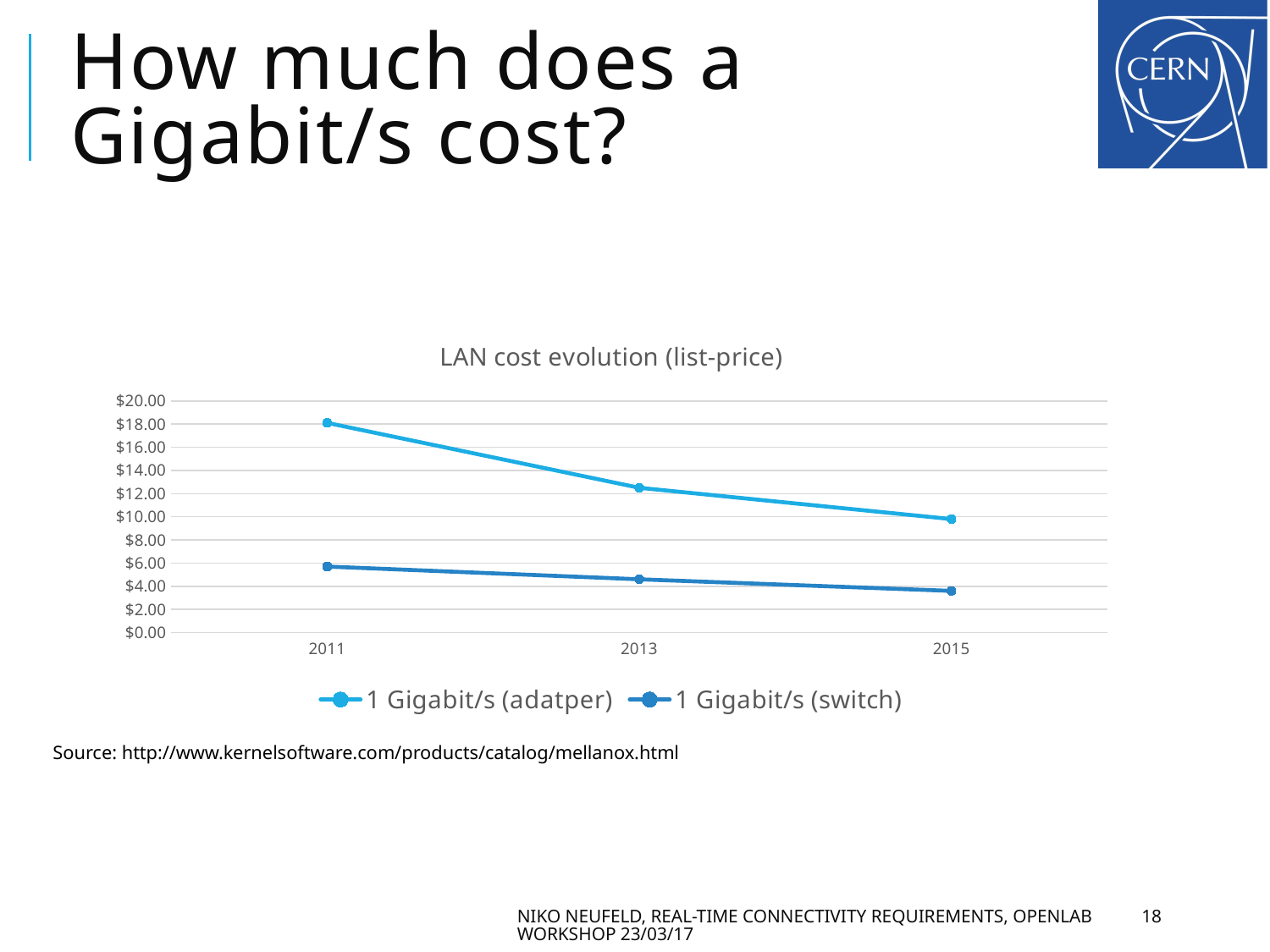
Does the cost for 1 Gigabit/s (switch) rise or fall from 2011 to 2015? fall In which year is the value for 1 Gigabit/s (adatper) highest? 2011 Is the value for 1 Gigabit/s (adatper) in 2015 greater or less than $12.00? less What kind of chart is shown on the slide? line chart How many years are plotted along the x axis? 3 Is the value for 1 Gigabit/s (adatper) in 2011 greater or less than $16.00? greater Does the cost for 1 Gigabit/s (adatper) rise or fall from 2011 to 2015? fall Is the value for 1 Gigabit/s (adatper) in 2013 greater or less than $10.00? greater What is the title of the chart? LAN cost evolution (list-price) How many series does the legend list? 2 Which series has the higher value in 2013, 1 Gigabit/s (adatper) or 1 Gigabit/s (switch)? 1 Gigabit/s (adatper)